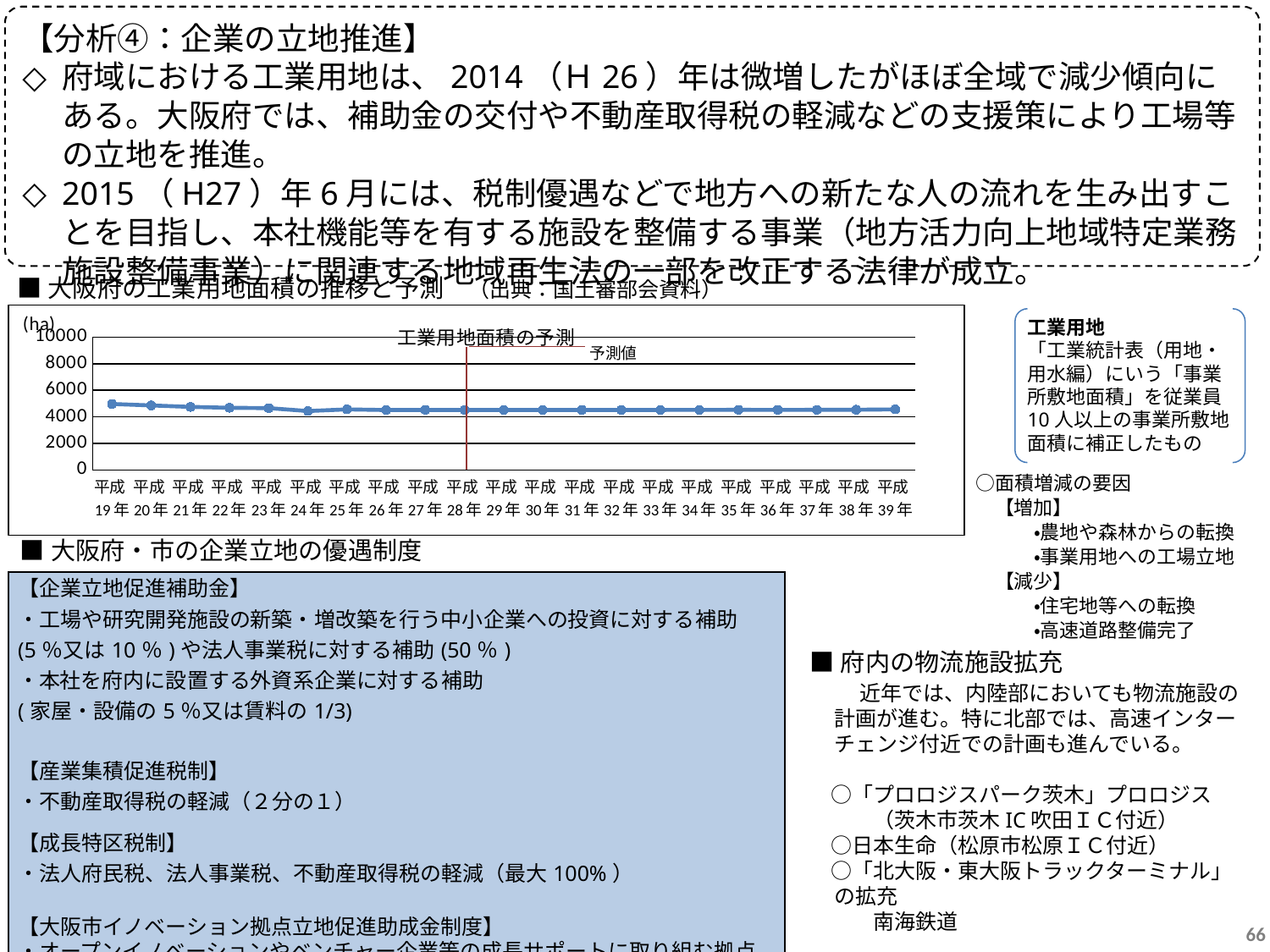
How many years are plotted along the x axis of the 工業用地面積 chart? 21 In the 工業用地面積 chart, which year has the highest value? 平成19年 What kind of chart is used to show 大阪府の工業用地面積の推移と予測? line chart In the 工業用地面積 chart, is the value for 平成39年 greater or less than 6000? less What unit is shown on the y axis of the 工業用地面積 chart? ha In the 工業用地面積 chart, which is larger, the value for 平成19年 or the value for 平成39年? 平成19年 In the 工業用地面積 chart, is the value for 平成19年 greater or less than 6000? less What is the highest tick value on the y axis of the 工業用地面積 chart? 10000 In the 工業用地面積 chart, is the value for 平成19年 greater or less than 4000? greater In the 工業用地面積 chart, do the values generally rise or fall from 平成19年 to 平成39年? fall